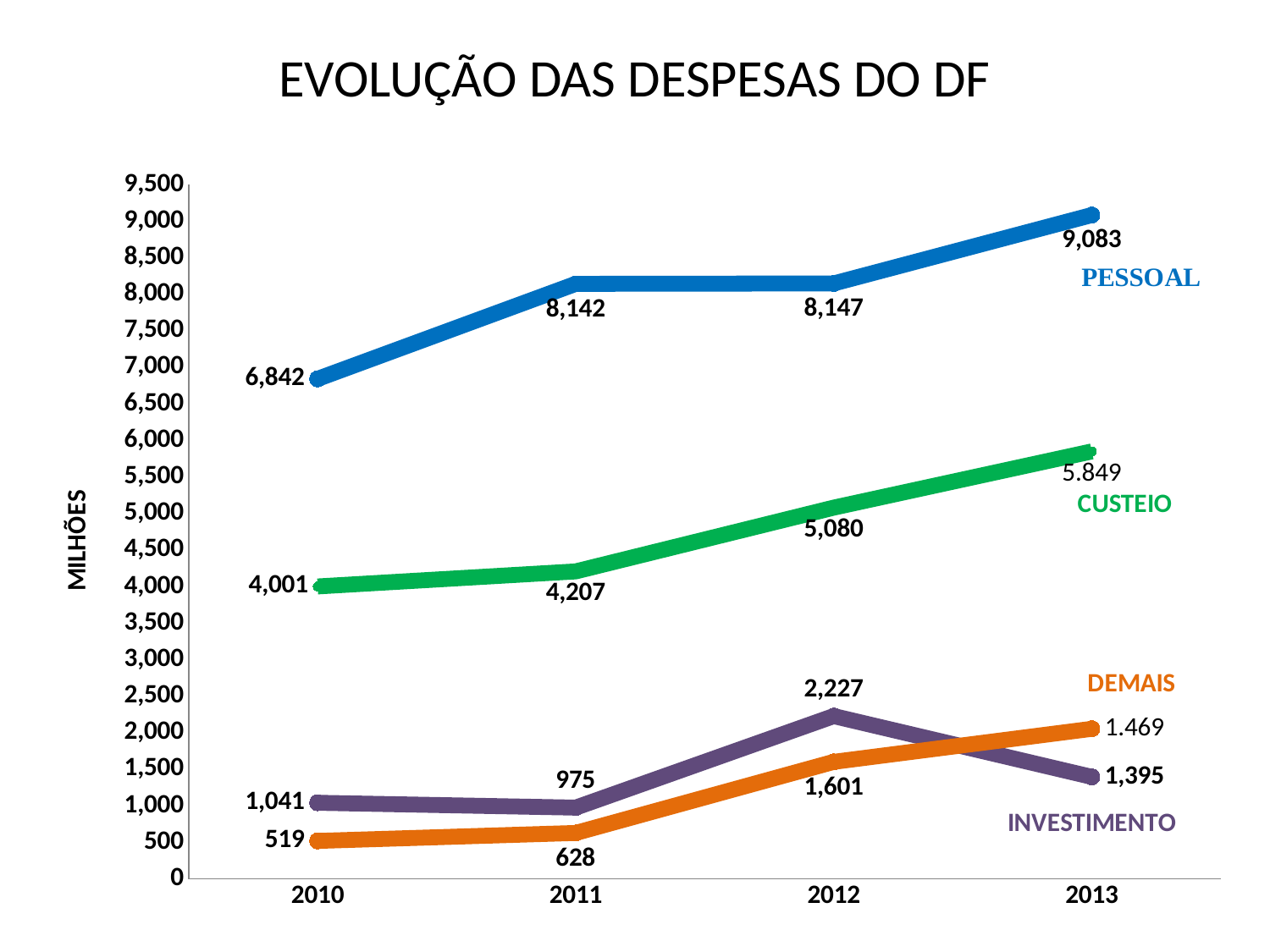
How many series are plotted in the chart? 4 What is the value for DEMAIS in 2011? 628 What type of chart is shown on the slide? line chart What is the value for INVESTIMENTO in 2012? 2,227 What is the difference between the PESSOAL values in 2013 and 2010? 2,241 Which is larger in 2012, the CUSTEIO value or the INVESTIMENTO value? CUSTEIO In which year is the INVESTIMENTO value highest? 2012 How many years are shown on the x axis? 4 What is the value for PESSOAL in 2013? 9,083 What is the value for CUSTEIO in 2010? 4,001 What is the title of the chart? EVOLUÇÃO DAS DESPESAS DO DF In which year is the PESSOAL value lowest? 2010